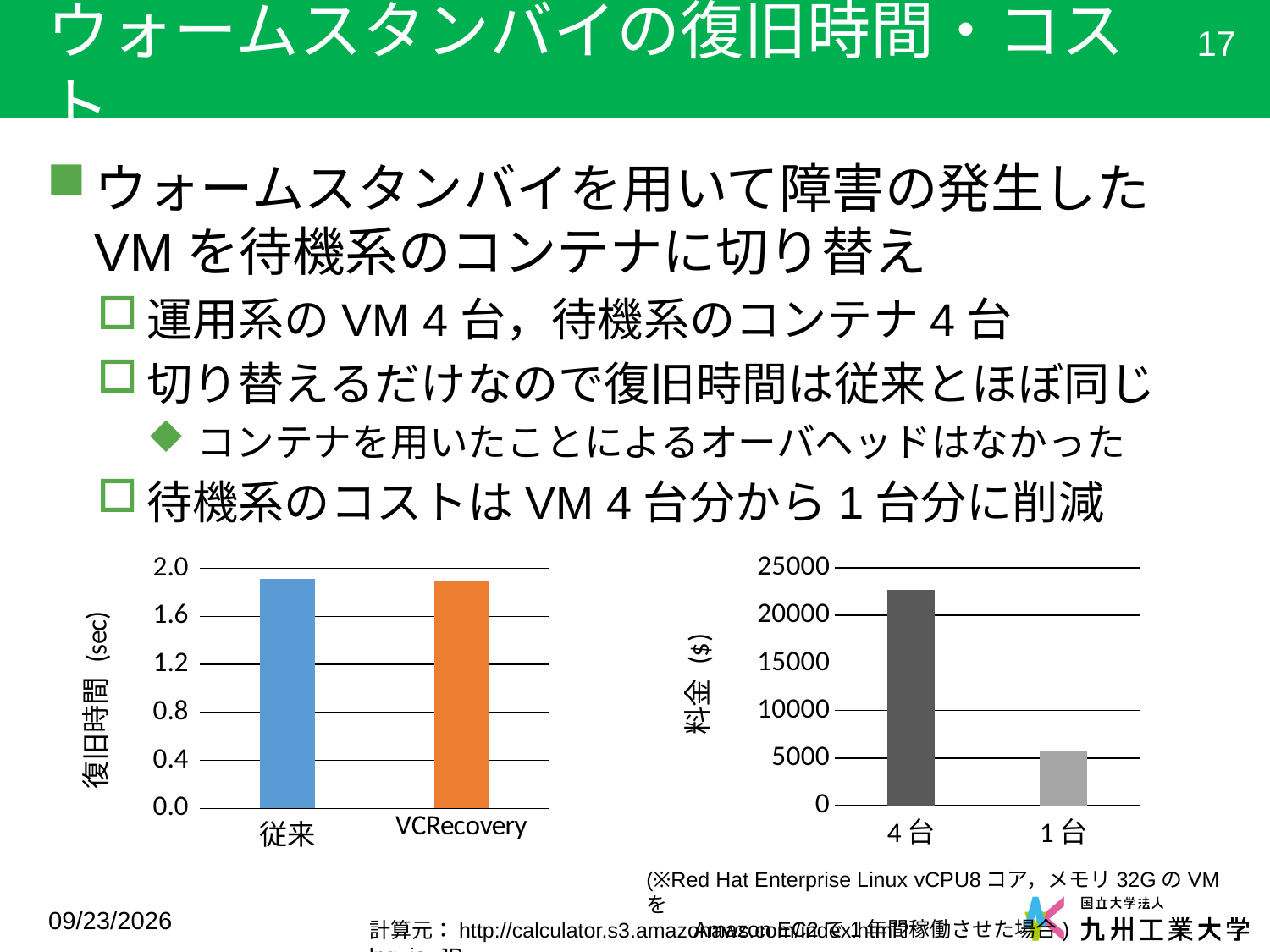
How many categories are shown on the x axis of the right chart (料金)? 2 What is the y-axis label of the left chart? 復旧時間 (sec) In the right chart (料金), which category has the highest value? 4台 How many categories are shown on the x axis of the left chart (復旧時間)? 2 In the right chart (料金), is the value for 1台 greater or less than 10000? less In the left chart (復旧時間), is the value for VCRecovery greater or less than 1.2? greater In the left chart (復旧時間), is the value for 従来 greater or less than 1.6? greater In the right chart (料金), which category has the lowest value? 1台 In the right chart (料金), which is larger, the value for 4台 or the value for 1台? 4台 What kind of chart is the right chart (料金)? bar chart What kind of chart is the left chart (復旧時間)? bar chart